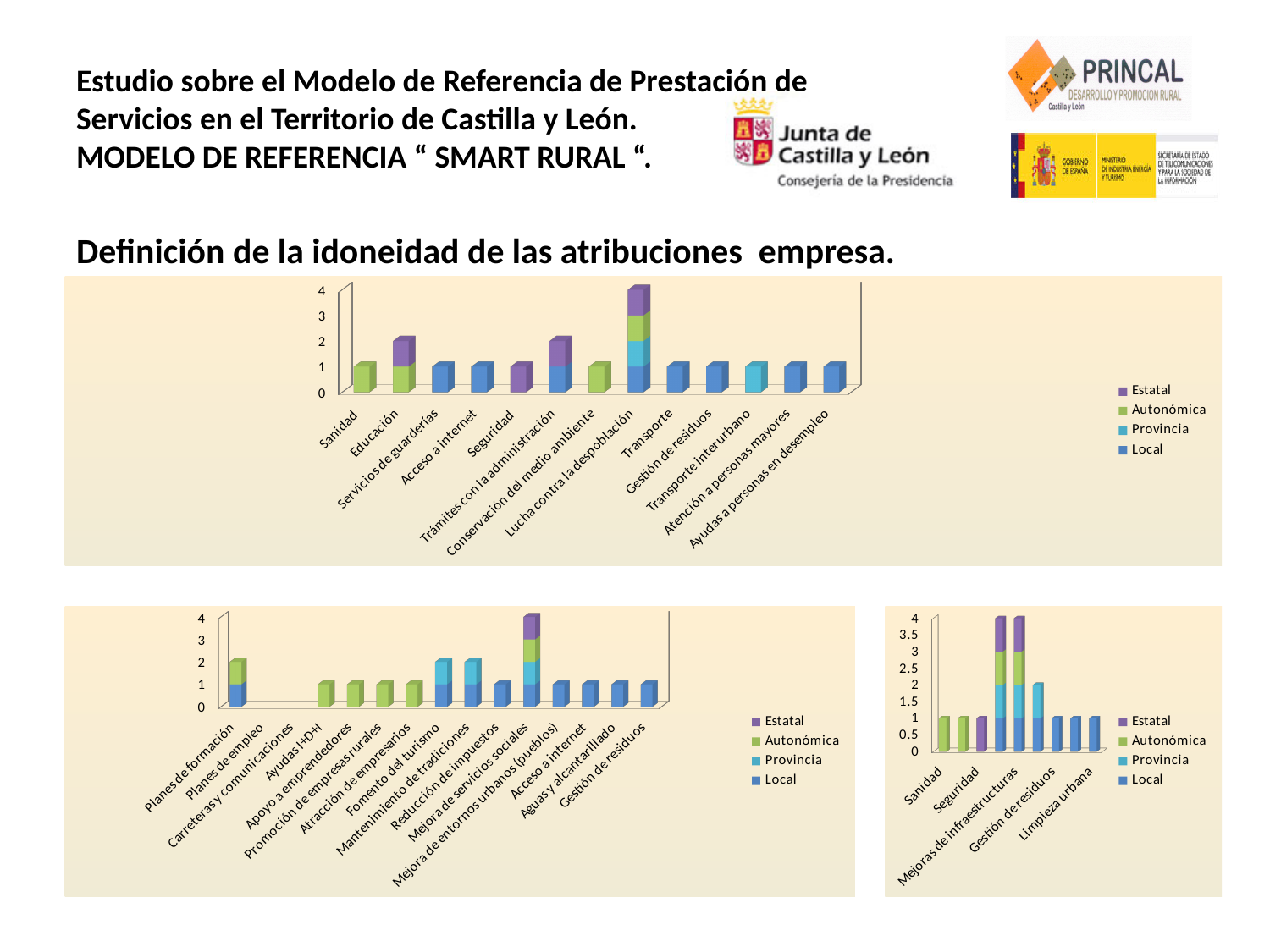
In the top chart, is the bar for Educación taller or shorter than the bar for Sanidad? taller In the top chart, which category has the tallest stacked bar? Lucha contra la despoblación What type of chart is the top chart on the slide? bar chart In the top chart, what is the total height of the stacked bar for Lucha contra la despoblación? 4 In the bottom-left chart, what is the total height of the stacked bar for Mejora de servicios sociales? 4 In the bottom-left chart, how many categories are listed on the x axis? 15 In the top chart, how many categories are shown on the x axis? 13 In the bottom-left chart, is the bar for Planes de formación taller or shorter than the bar for Ayudas I+D+I? taller In the top chart, what is the total height of the stacked bar for Educación? 2 In the bottom-right chart, what are the four series listed in the legend? Estatal, Autonómica, Provincia, Local In the bottom-left chart, which category has the tallest stacked bar? Mejora de servicios sociales In the top chart, how many series does the legend list? 4